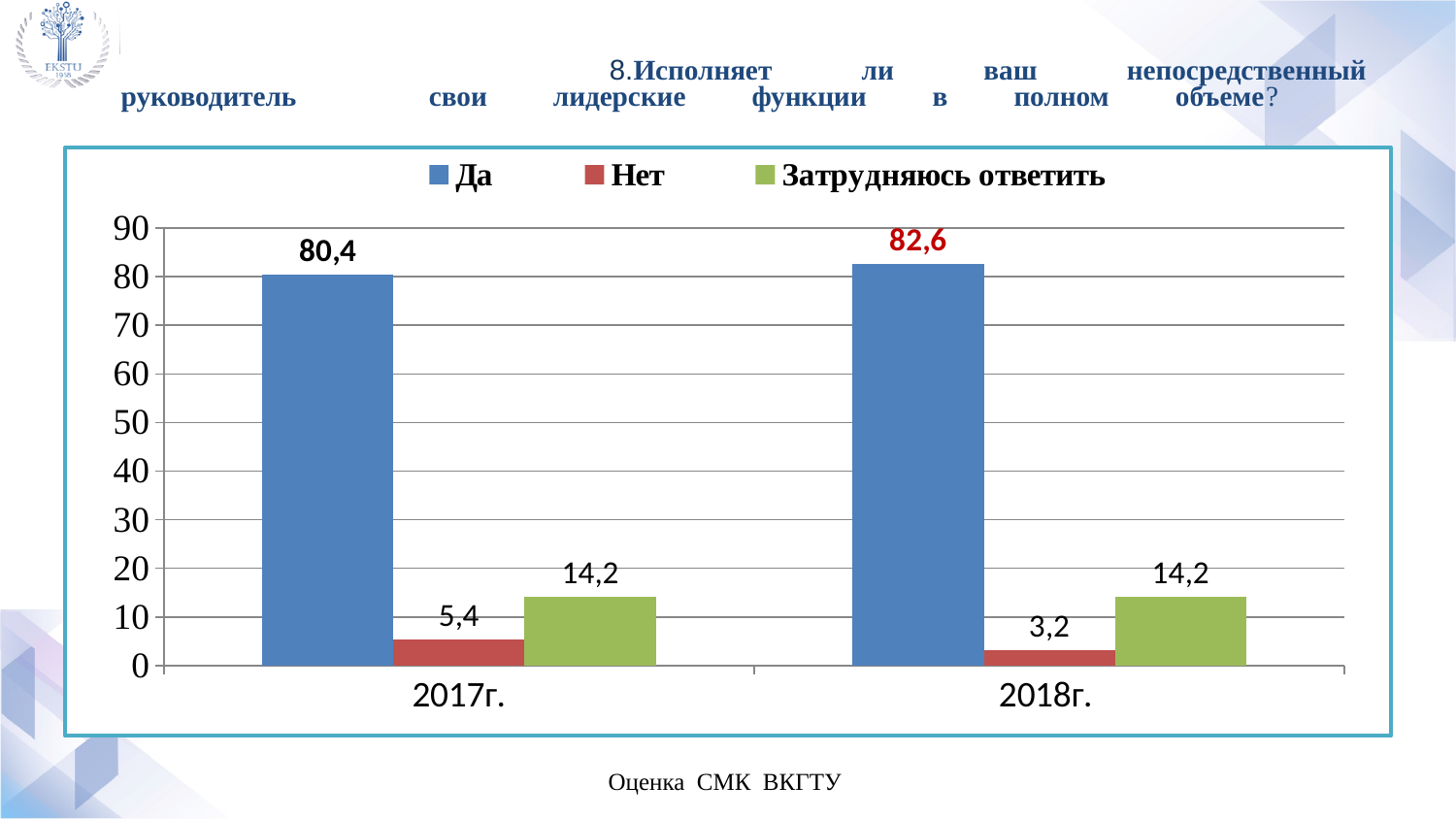
Which series has the highest value in 2018г.? Да How many categories are shown on the x axis? 2 What kind of chart is shown on the slide? Bar chart Which series has the lowest value in 2017г.? Нет What is the difference between the "Да" values for 2018г. and 2017г.? 2,2 How many series does the legend list? 3 What is the value for "Нет" in 2018г.? 3,2 What is the difference between the "Нет" values for 2017г. and 2018г.? 2,2 Which is larger: the "Нет" value in 2017г. or in 2018г.? 2017г. What is the value for "Да" in 2018г.? 82,6 What is the value for "Да" in 2017г.? 80,4 What is the value for "Затрудняюсь ответить" in 2017г.? 14,2